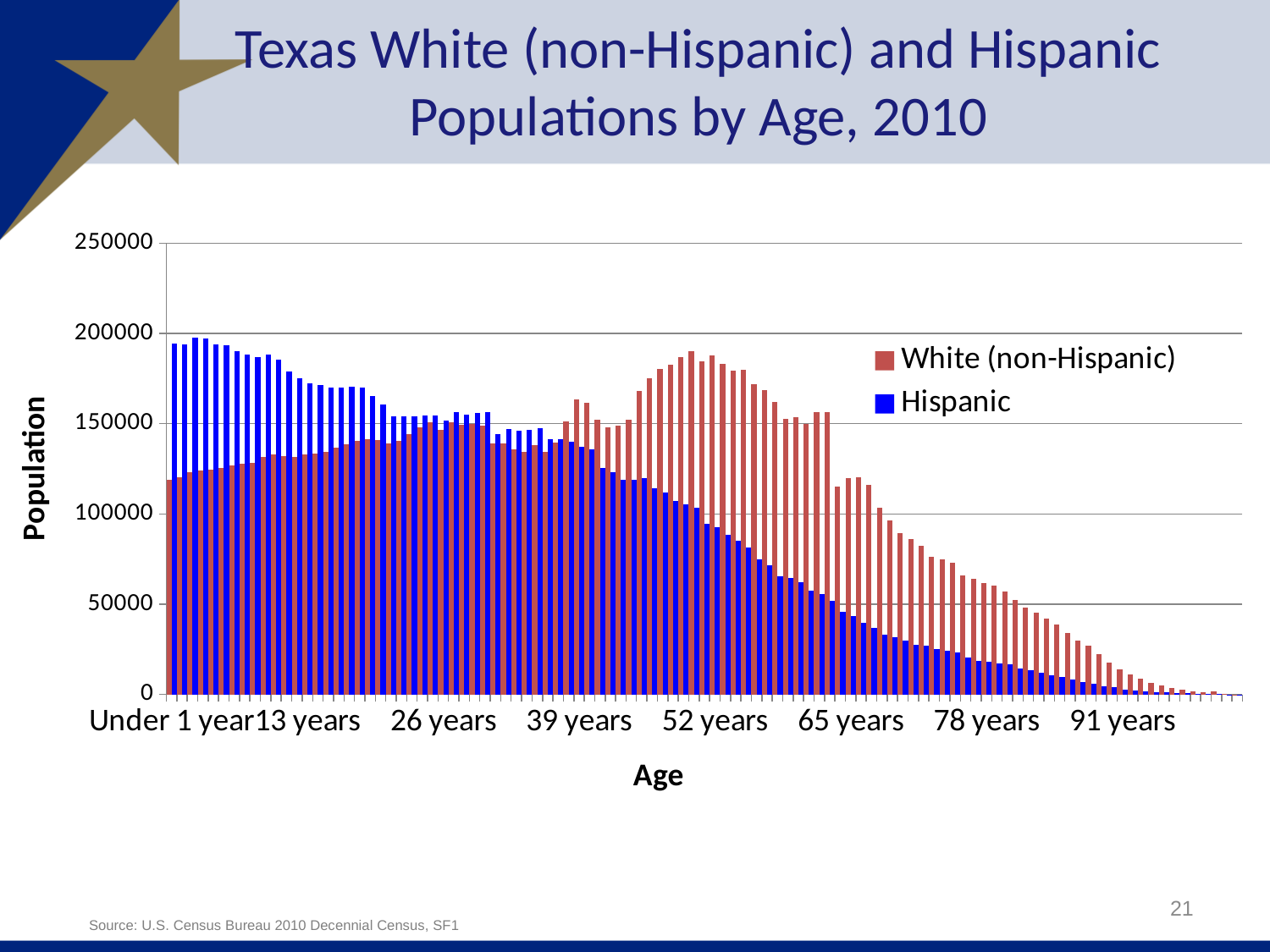
Which series has the larger value at Under 1 year, White (non-Hispanic) or Hispanic? Hispanic Is the Hispanic value for Under 1 year greater or less than 150000? greater What kind of chart is shown on the slide? Bar chart Which series has the larger value at 52 years, White (non-Hispanic) or Hispanic? White (non-Hispanic) Is the White (non-Hispanic) value for 52 years greater or less than 150000? greater Which colour represents the Hispanic series in the chart? Blue How many series does the legend list? 2 Do the Hispanic values generally rise or fall from 52 years to 91 years? Fall Is the White (non-Hispanic) value for Under 1 year greater or less than 150000? less What is the title of the chart? Texas White (non-Hispanic) and Hispanic Populations by Age, 2010